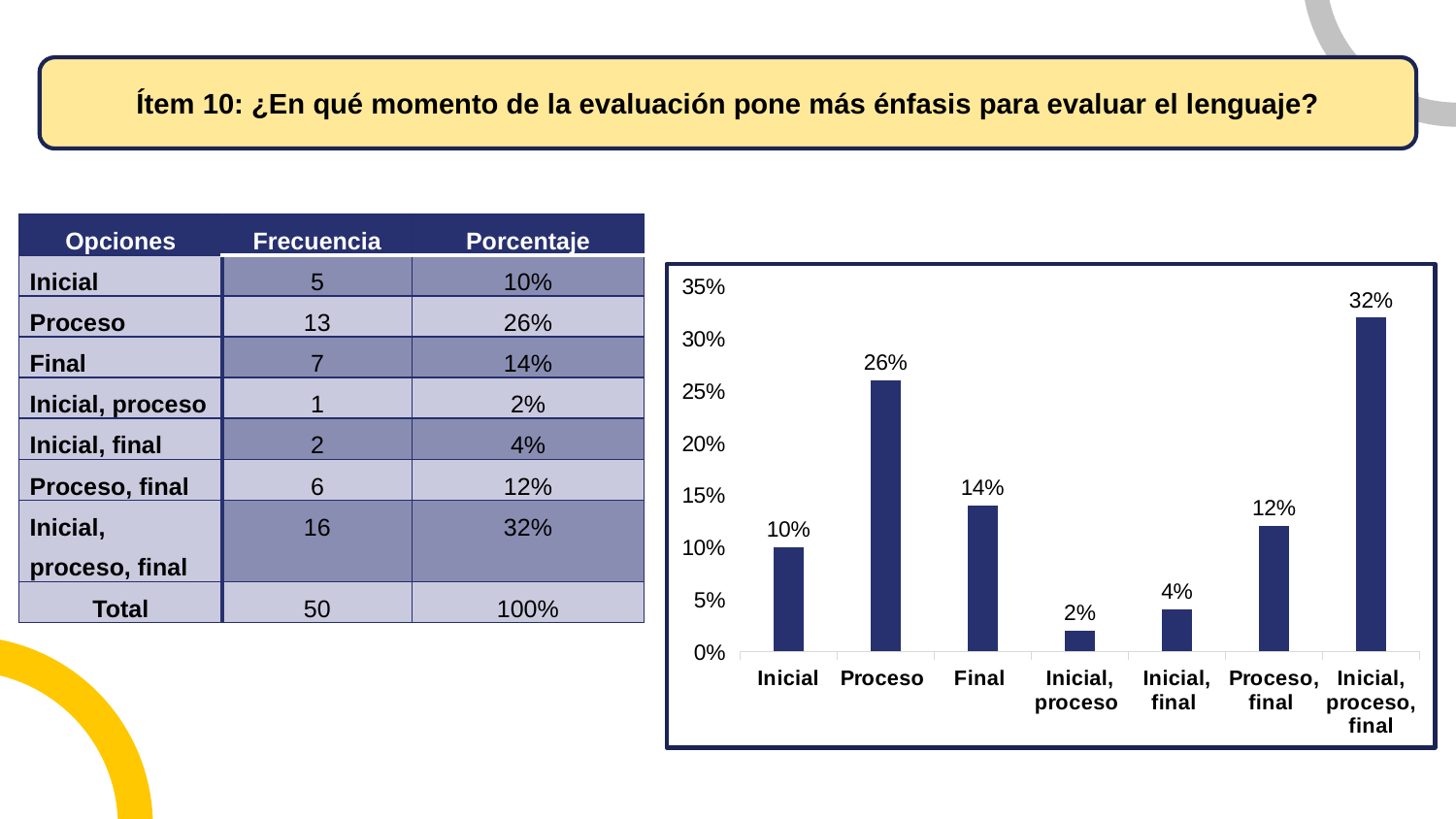
How many categories are shown on the x axis of the chart? 7 What is the difference between the values for Inicial, proceso, final and Proceso? 6% What is the value for Proceso in the chart? 26% What kind of chart is shown on the slide? bar chart Which category has the lowest value in the chart? Inicial, proceso Which category has the highest value in the chart? Inicial, proceso, final What is the value for Proceso, final in the chart? 12% What is the highest tick value shown on the y axis of the chart? 35% Which is larger, the value for Final or the value for Proceso, final? Final What is the value for Inicial, final in the chart? 4% Is the value for Proceso greater or less than 20%? greater What is the difference between the values for Final and Inicial? 4%